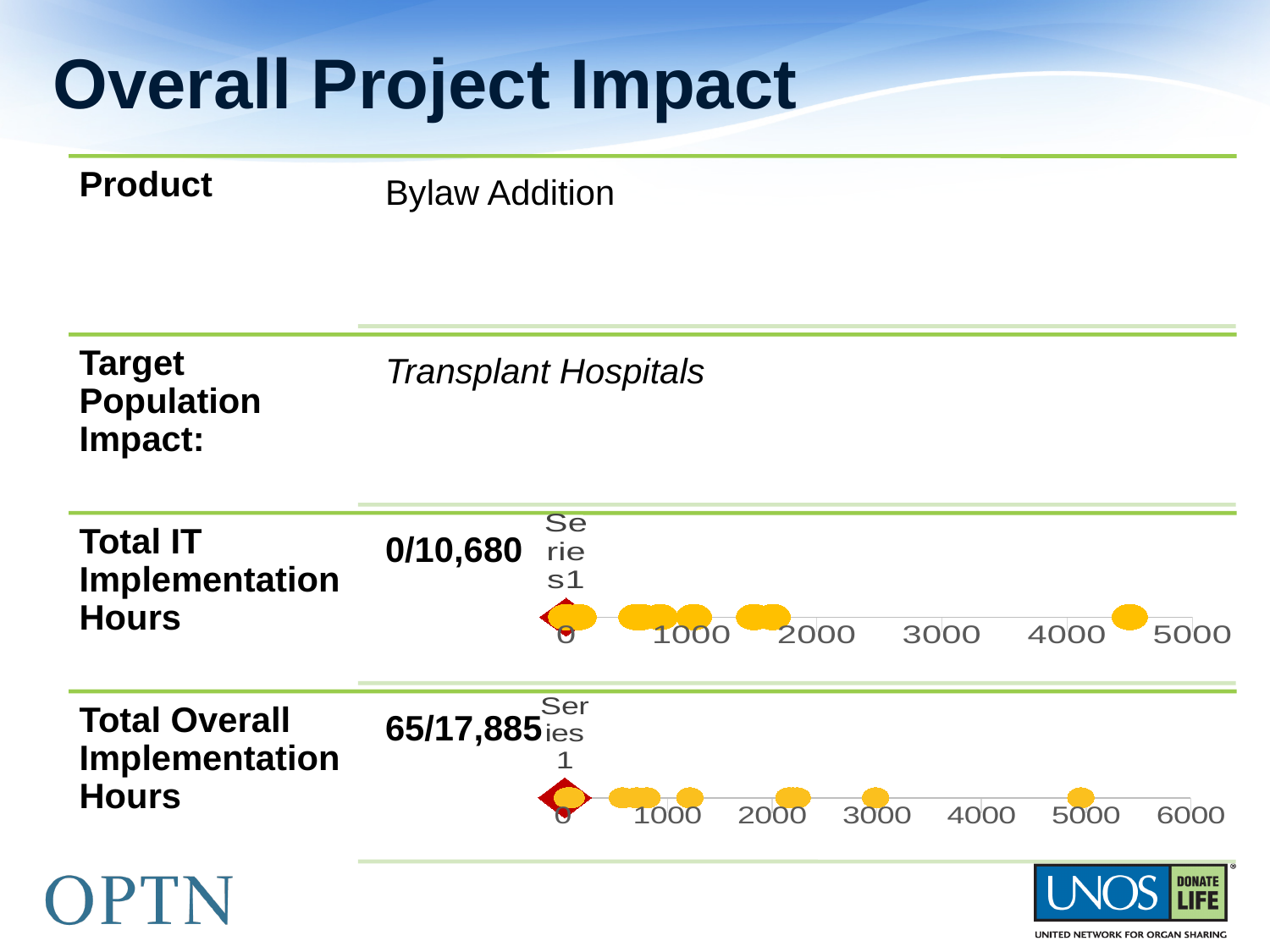
In the chart next to Total IT Implementation Hours, is the value marked by the red diamond greater or less than 1000? less In the chart next to Total IT Implementation Hours, is the rightmost yellow point greater or less than 3000? greater In the chart next to Total Overall Implementation Hours, what is the highest tick label on the x axis? 6000 What kind of chart is shown next to Total IT Implementation Hours? scatter chart In the chart next to Total IT Implementation Hours, what is the highest tick label on the x axis? 5000 In the chart next to Total Overall Implementation Hours, is the leftmost yellow point greater or less than 1000? less What kind of chart is shown next to Total Overall Implementation Hours? scatter chart